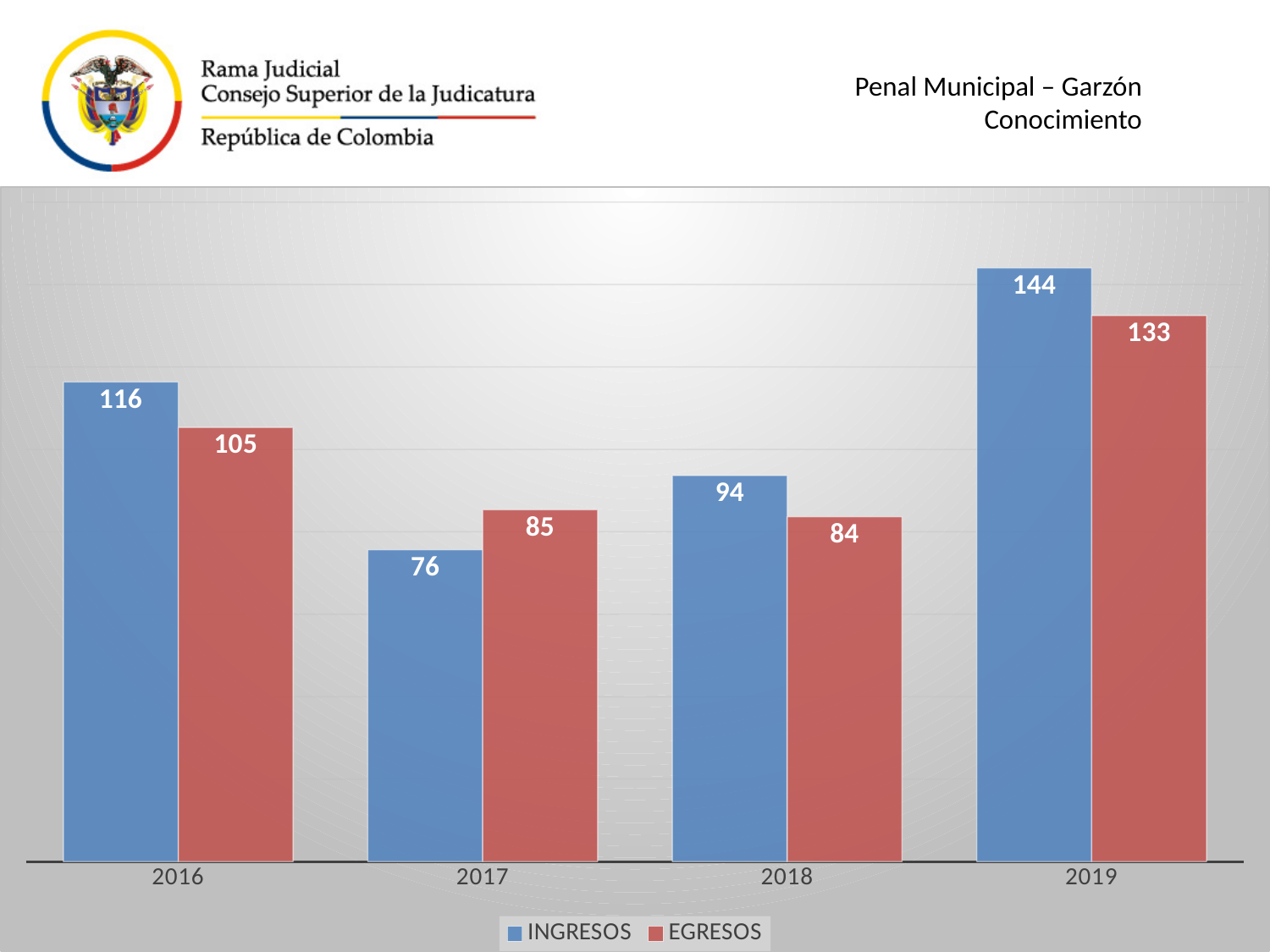
What is the EGRESOS value for 2019? 133 Which year has the lowest EGRESOS value? 2018 Which year has the highest INGRESOS value? 2019 Which is larger in 2017, INGRESOS or EGRESOS? EGRESOS How many series does the legend list? 2 What is the EGRESOS value for 2018? 84 How many years are shown on the x axis? 4 What is the difference between INGRESOS and EGRESOS in 2019? 11 Which series is shown in red? EGRESOS What kind of chart is shown on the slide? Bar chart What is the difference between INGRESOS in 2016 and INGRESOS in 2017? 40 What is the INGRESOS value for 2016? 116